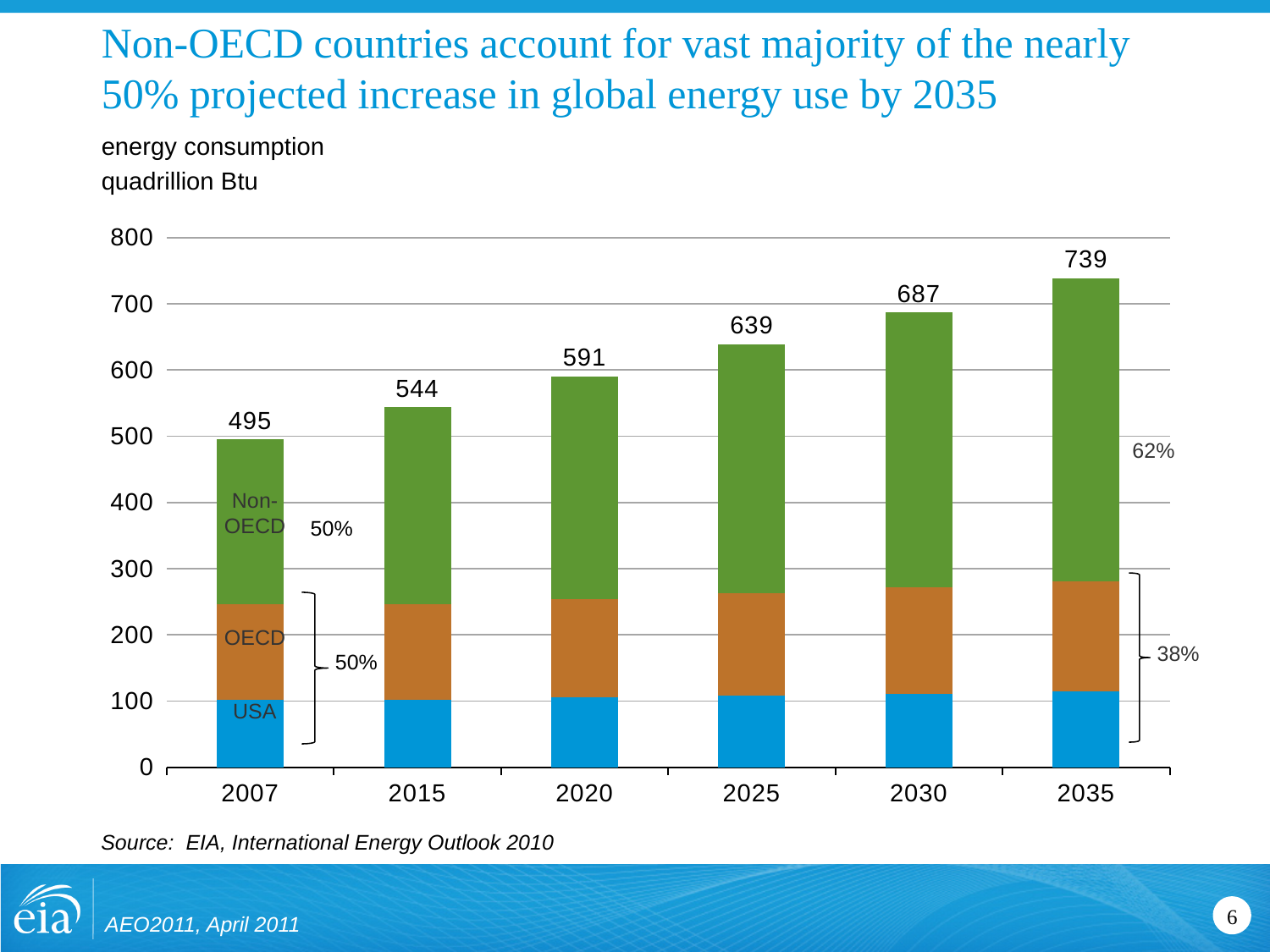
Is the USA segment for 2035 greater or less than 200? less What is the total energy consumption shown for 2035? 739 Which is larger, the total for 2015 or the total for 2025? 2025 How many years are shown on the x axis? 6 What is the total energy consumption shown for 2020? 591 What is the difference between the total for 2030 and the total for 2025? 48 What kind of chart is shown on the slide? stacked bar chart Which year has the lowest total energy consumption? 2007 What is the difference between the total for 2035 and the total for 2007? 244 What is the total energy consumption shown for 2007? 495 Do the total values rise or fall from 2007 to 2035? rise Which year has the highest total energy consumption? 2035